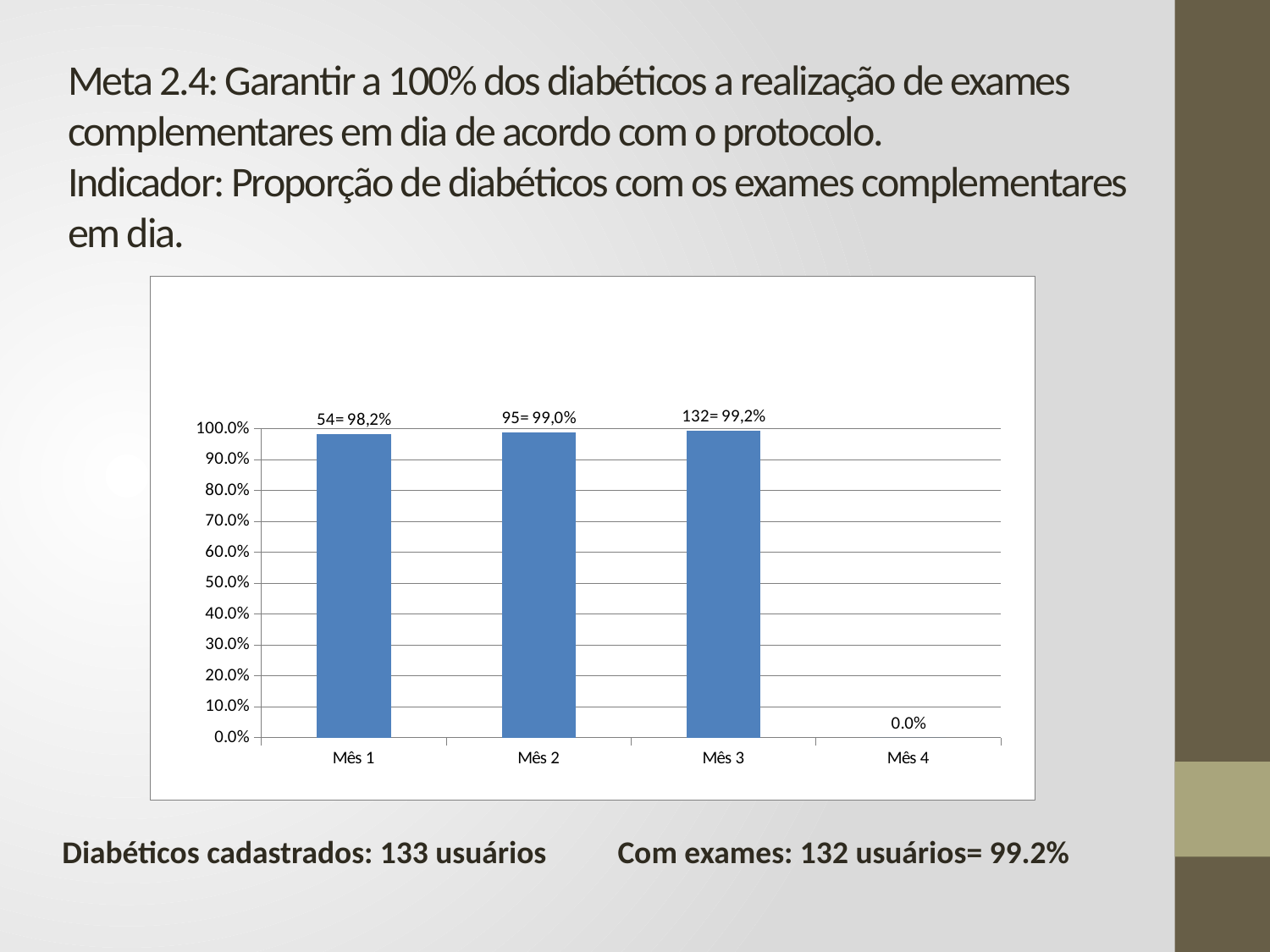
Which month has the lowest value in the chart? Mês 4 What is the difference in percentage points between Mês 3 and Mês 1? 1,0 What percentage is shown for Mês 2? 99,0% Which has a higher percentage, Mês 1 or Mês 2? Mês 2 Is the value for Mês 1 greater or less than 90.0%? greater How many categories are shown on the x axis of the chart? 4 What kind of chart is shown on the slide? bar chart Do the values rise or fall from Mês 1 to Mês 3? rise What value is shown for Mês 4? 0.0% Which month has the highest percentage in the chart? Mês 3 What percentage is shown for Mês 3? 99,2% What is the data label shown above the bar for Mês 1? 54= 98,2%